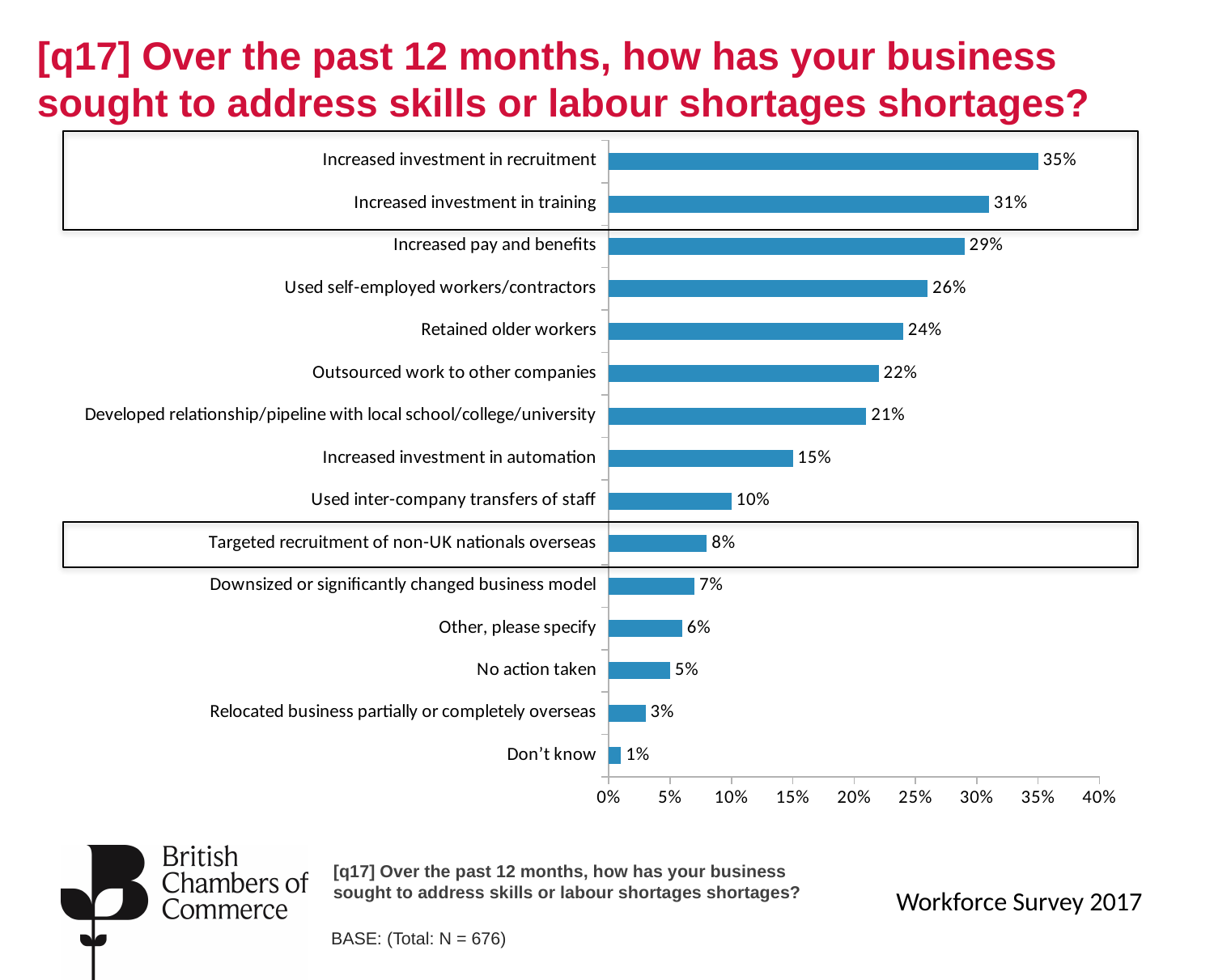
What percentage of businesses targeted recruitment of non-UK nationals overseas? 8% What is the value for 'Retained older workers'? 24% Which category has the lowest value? Don't know What is the base sample size (N) stated on the slide? 676 Is the value for 'Increased investment in automation' greater or less than 20%? less What is the difference between 'Increased investment in recruitment' and 'Increased investment in training'? 4% What kind of chart is shown on the slide? Bar chart What is the difference between 'Increased pay and benefits' and 'No action taken'? 24% How many categories are shown in the chart? 15 Which category has the highest value? Increased investment in recruitment What percentage of businesses increased investment in recruitment? 35% Which is larger: 'Used self-employed workers/contractors' or 'Outsourced work to other companies'? Used self-employed workers/contractors